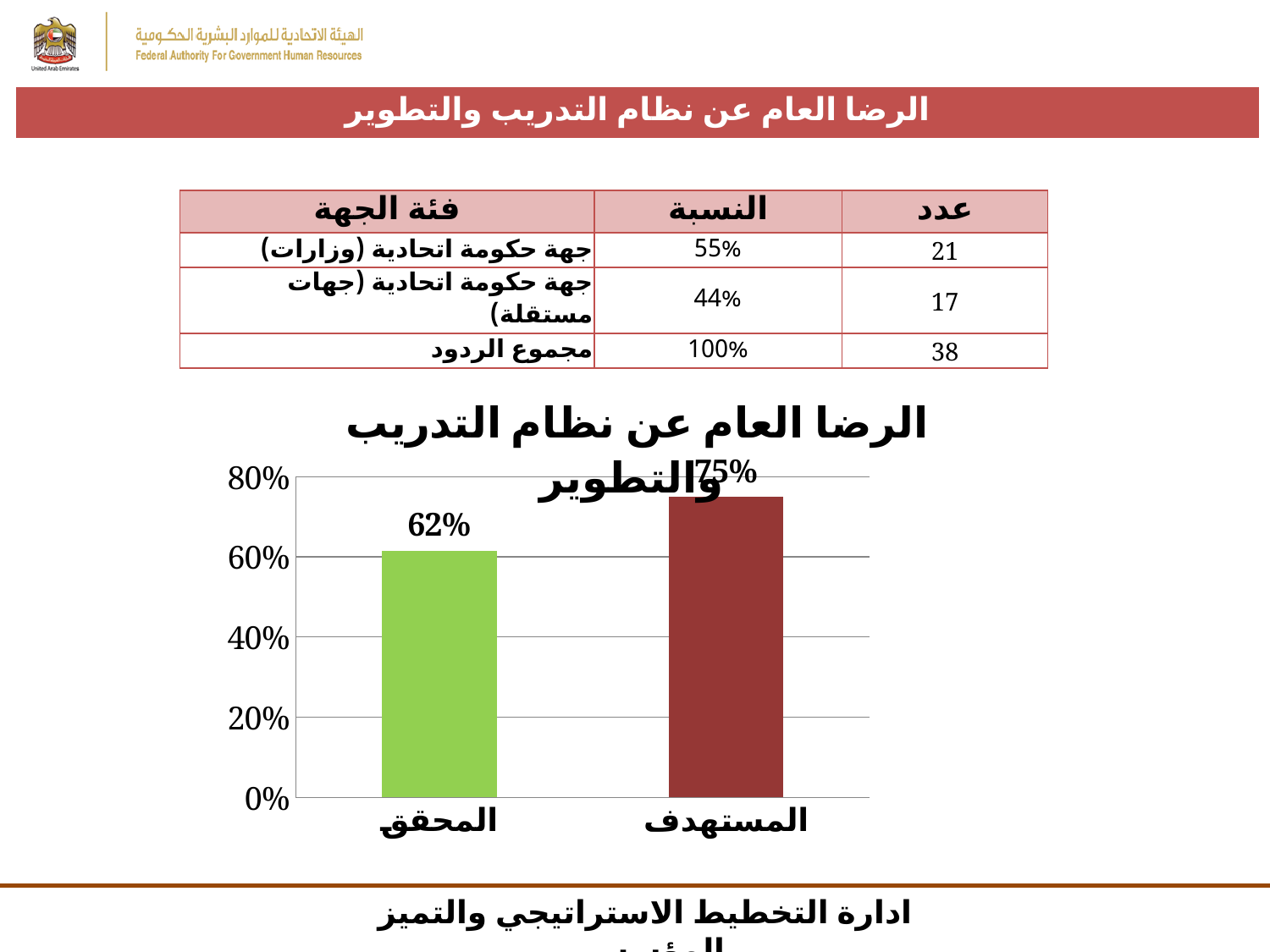
What is the value for المستهدف in the chart? 75% Is the value for المستهدف greater or less than 80%? less What is the value for المحقق in the chart? 62% What kind of chart is shown on the slide? bar chart Is the value for المحقق greater or less than 60%? greater How many bars are plotted in the chart? 2 Which is larger, the value for المحقق or the value for المستهدف? المستهدف What is the difference between the values for المستهدف and المحقق? 13% What is the title of the chart? الرضا العام عن نظام التدريب والتطوير Which category has the lowest value in the chart? المحقق Which category has the highest value in the chart? المستهدف What colour is the bar for المحقق? green